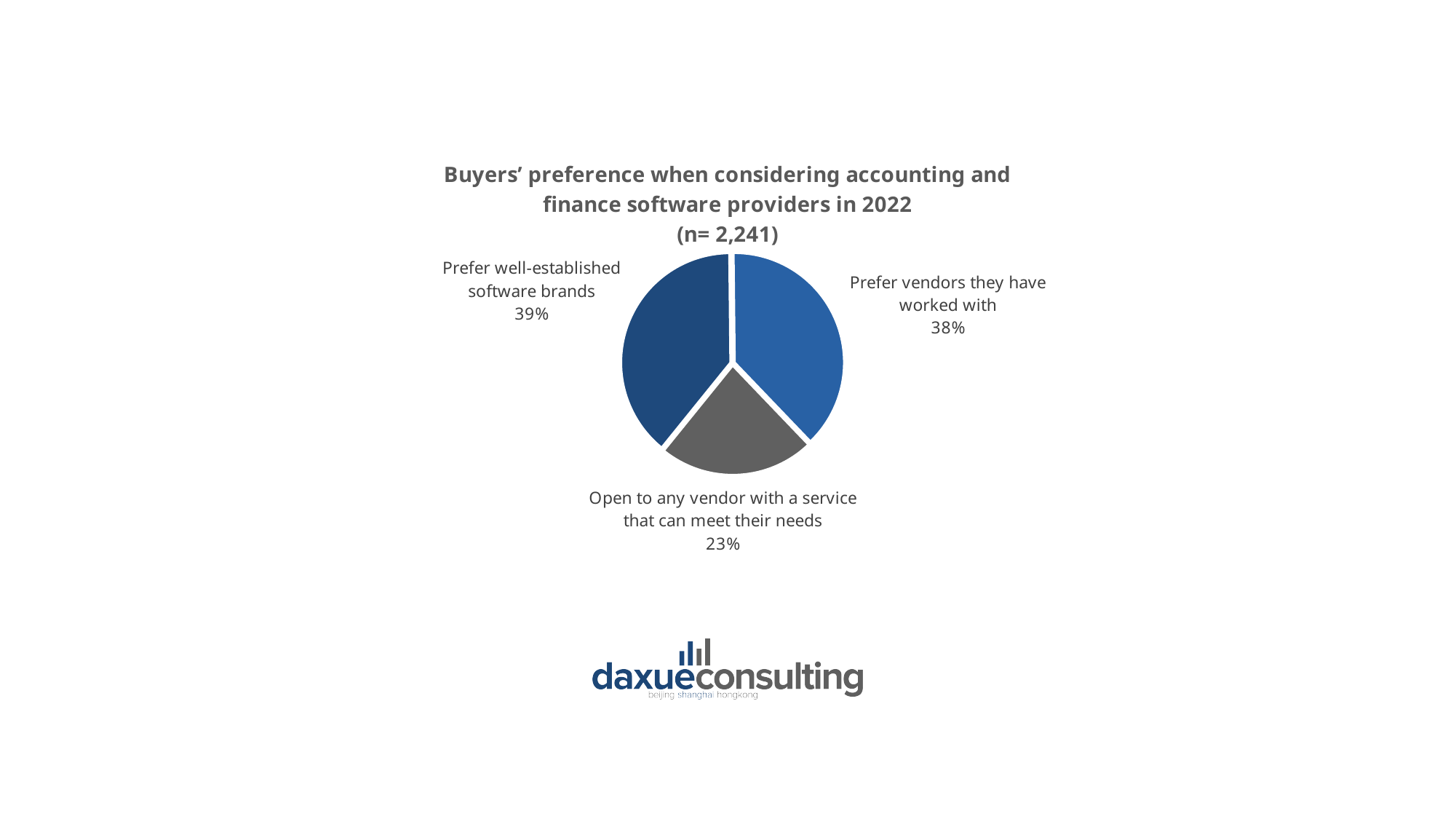
What kind of chart is shown on the slide? Pie chart What share of buyers are open to any vendor with a service that can meet their needs? 23% Which category has the smallest share of the pie? Open to any vendor with a service that can meet their needs What is the sample size (n) stated in the chart title? 2,241 How many slices does the pie chart have? 3 What is the combined share of buyers who prefer well-established software brands and those who prefer vendors they have worked with? 77% What share of buyers prefer well-established software brands? 39% What share of buyers prefer vendors they have worked with? 38% What is the difference in percentage points between buyers who prefer vendors they have worked with and those open to any vendor with a service that can meet their needs? 15 percentage points Which year does the chart title say the data refers to? 2022 What is the difference in percentage points between buyers who prefer well-established software brands and those open to any vendor with a service that can meet their needs? 16 percentage points